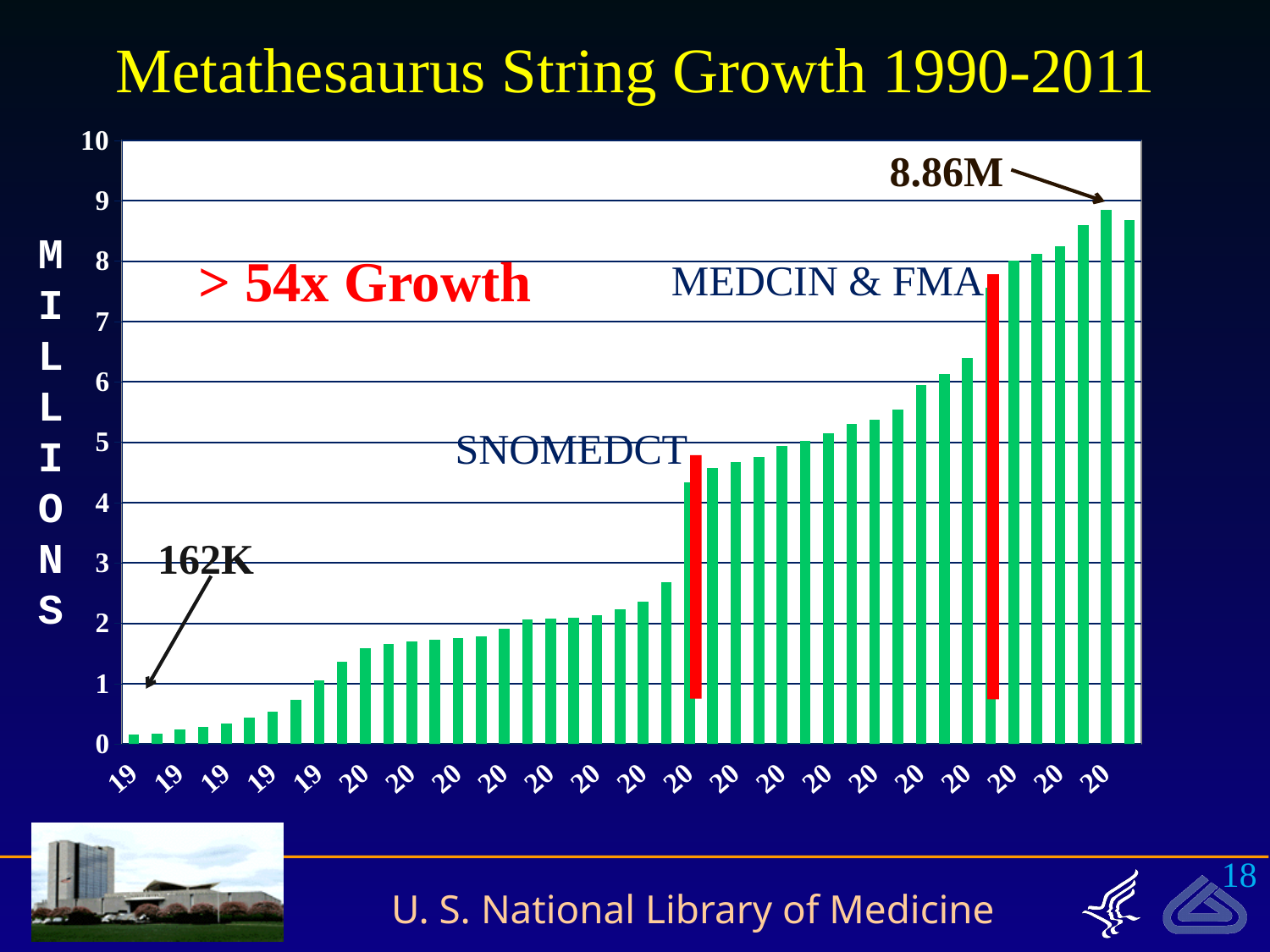
What unit does the vertical axis of the chart use? Millions Is the value of the first bar greater or less than 1 million? less Which is larger, the first bar (162K) or the tallest bar (8.86M)? the tallest bar (8.86M) What value is labelled for the tallest bar in the chart? 8.86M Is the value of the tallest bar greater or less than 8 million? greater What value is labelled for the first bar in the chart? 162K What kind of chart is shown on the slide? bar chart Do the bar values generally rise or fall from left to right across the chart? rise Is the value of the tallest bar greater or less than 9 million? less What is the title of the chart? Metathesaurus String Growth 1990-2011